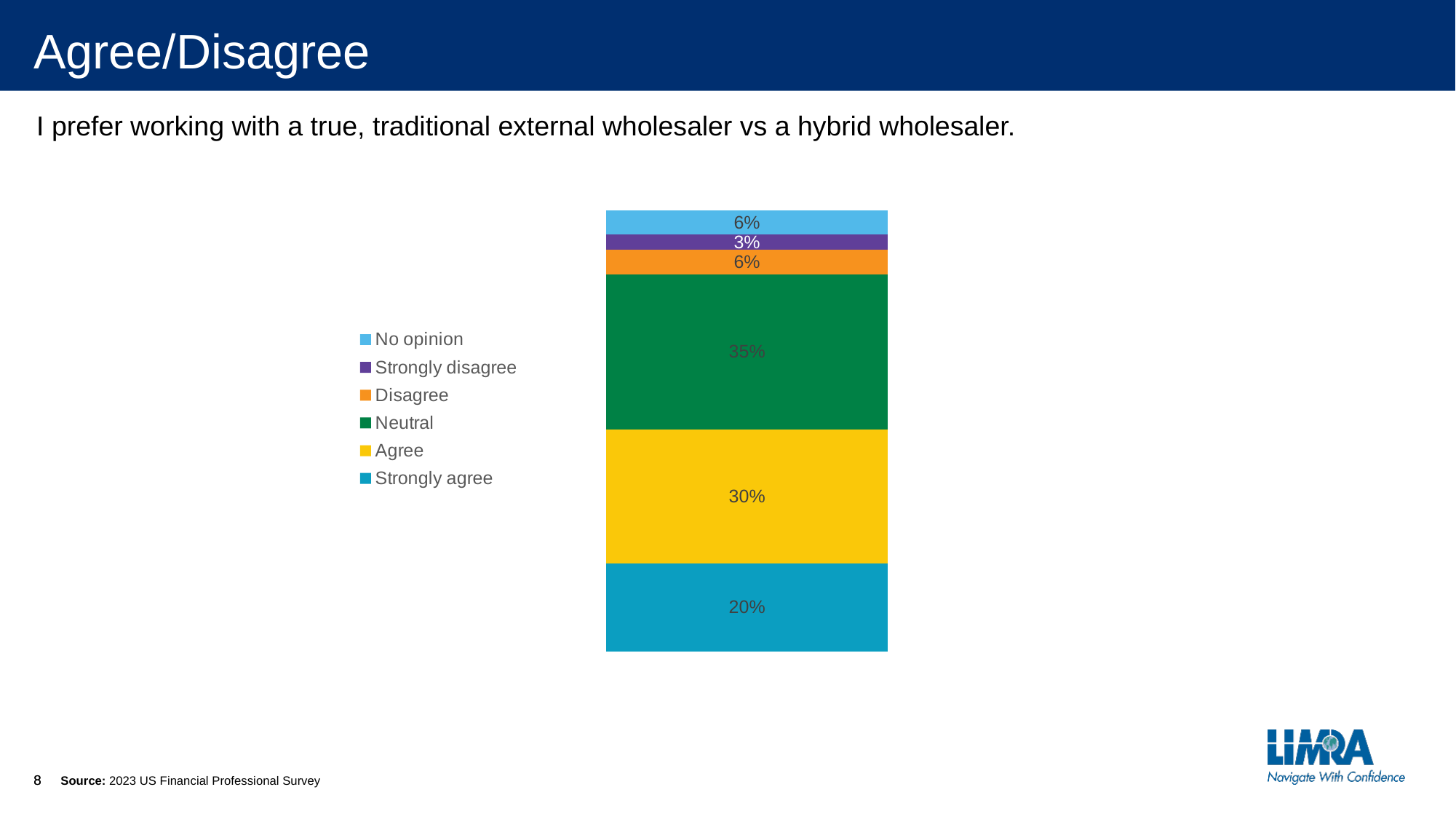
How many series does the legend list? 6 Which is larger, the share for Agree or the share for Strongly agree? Agree What percentage of respondents answered Agree? 30% What is the combined percentage for Agree and Strongly agree? 50% What percentage of respondents answered Strongly agree? 20% What is the difference in percentage points between Neutral and Agree? 5 Which response category has the smallest share? Strongly disagree Which response category has the largest share? Neutral Which colour represents Neutral in the chart? Green What percentage of respondents answered Strongly disagree? 3% What kind of chart is shown on the slide? Stacked bar chart What percentage of respondents answered Neutral? 35%